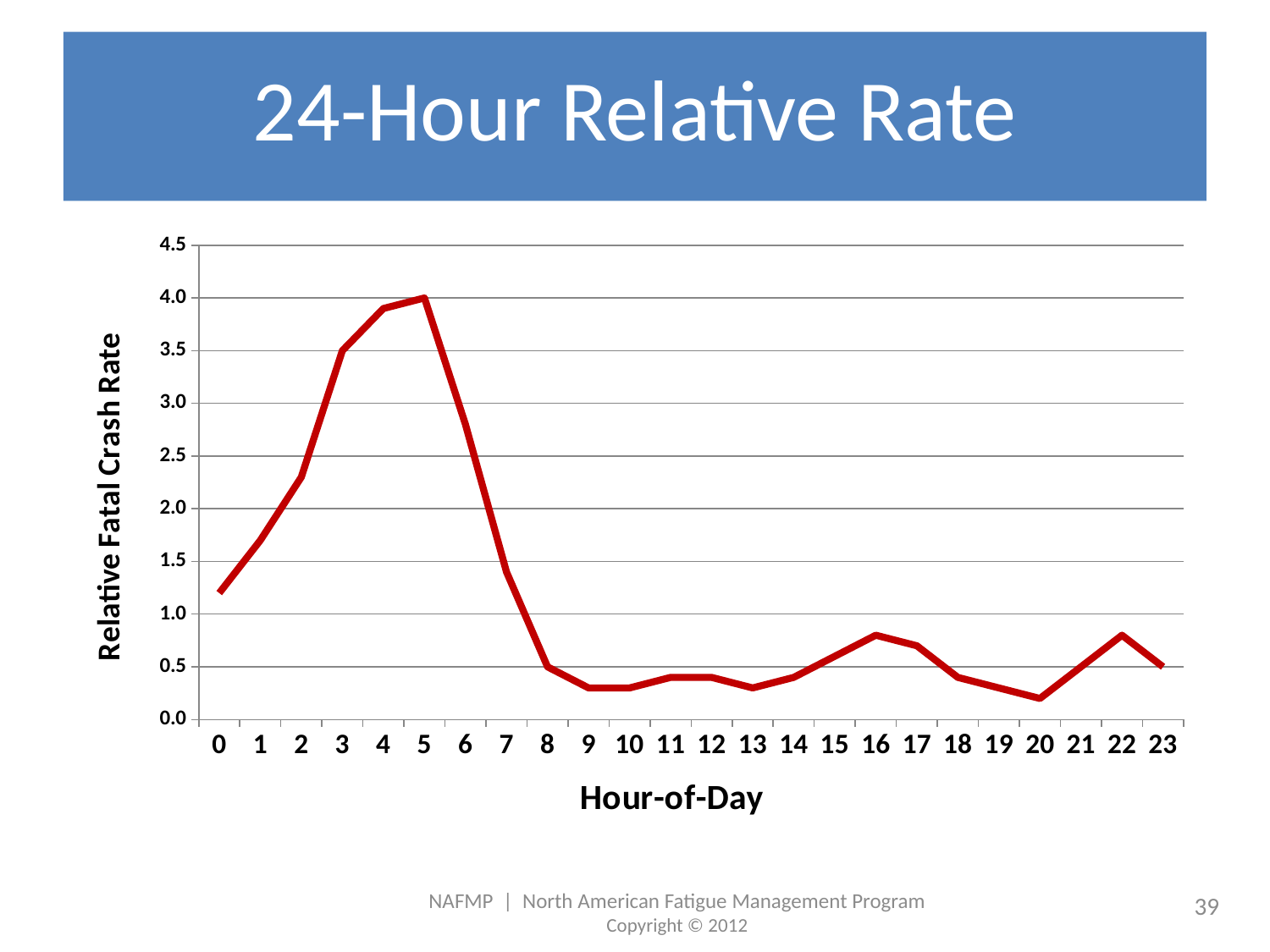
What is the label of the vertical axis? Relative Fatal Crash Rate Is the relative fatal crash rate at hour 16 greater or less than 0.5? greater Is the relative fatal crash rate at hour 0 greater or less than 1.0? greater What is the relative fatal crash rate at hour 5? 4.0 Which hour has a higher relative fatal crash rate, hour 3 or hour 16? hour 3 Is the relative fatal crash rate at hour 4 greater or less than 3.5? greater At which hour of day is the relative fatal crash rate lowest? 20 Does the relative fatal crash rate rise or fall from hour 0 to hour 5? rise How many hour-of-day points are plotted on the chart? 24 At which hour of day is the relative fatal crash rate highest? 5 What kind of chart is shown on the slide? line chart